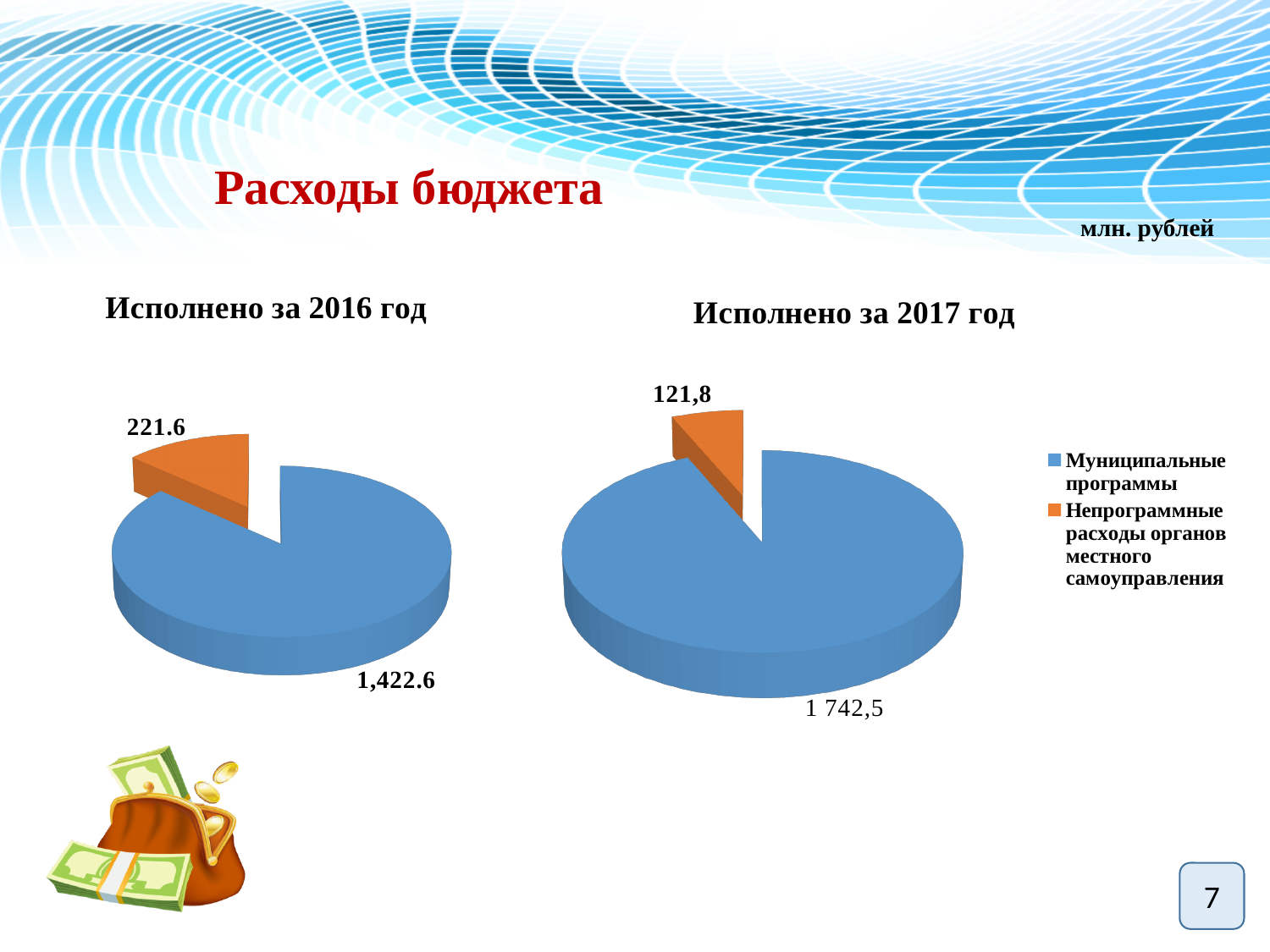
In the chart titled "Исполнено за 2016 год", which category has the largest slice? Муниципальные программы In the chart titled "Исполнено за 2017 год", which category has the smallest slice? Непрограммные расходы органов местного самоуправления In the chart titled "Исполнено за 2017 год", what is the difference between the value for Муниципальные программы and the value for Непрограммные расходы органов местного самоуправления? 1 620,7 How many slices does the chart titled "Исполнено за 2016 год" have? 2 What kind of chart is the chart titled "Исполнено за 2017 год"? pie chart In the chart titled "Исполнено за 2016 год", what is the value for Муниципальные программы? 1,422.6 What colour is the slice for Муниципальные программы in the chart titled "Исполнено за 2017 год"? blue In the chart titled "Исполнено за 2016 год", what is the value for Непрограммные расходы органов местного самоуправления? 221.6 In the chart titled "Исполнено за 2017 год", what is the value for Непрограммные расходы органов местного самоуправления? 121,8 In the chart titled "Исполнено за 2017 год", what is the value for Муниципальные программы? 1 742,5 In the chart titled "Исполнено за 2016 год", what is the difference between the value for Муниципальные программы and the value for Непрограммные расходы органов местного самоуправления? 1,201.0 Is the value for Непрограммные расходы органов местного самоуправления larger in the chart titled "Исполнено за 2016 год" or in the chart titled "Исполнено за 2017 год"? Исполнено за 2016 год